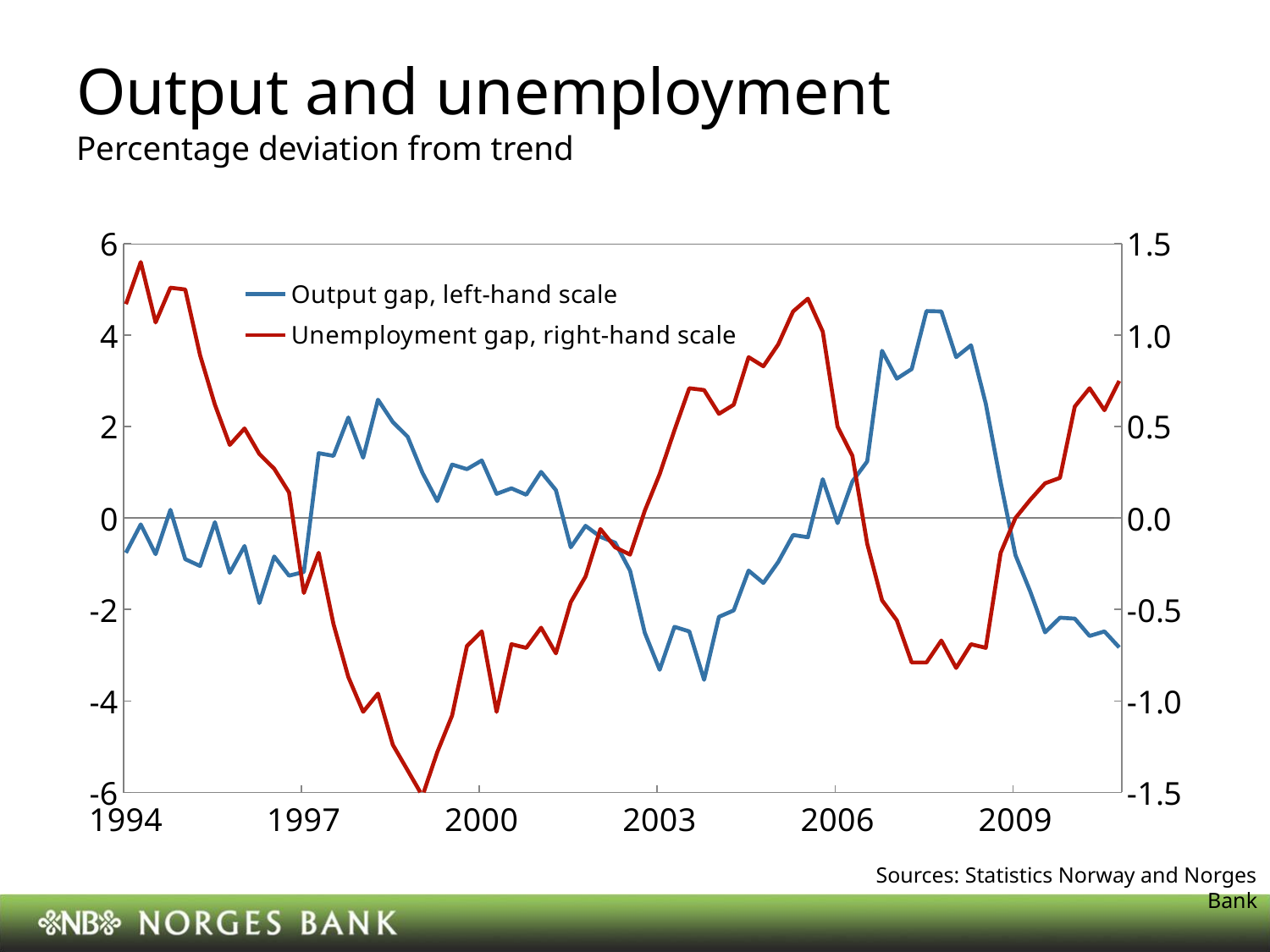
Is the peak value of the output gap around 2008 greater or less than 4 on the left-hand scale? greater Is the output gap at the start of 1994 greater or less than 0? less Which series is plotted against the right-hand scale? Unemployment gap Does the output gap rise or fall between 2006 and 2008? rise What kind of chart is shown on the slide? line chart Is the lowest value of the unemployment gap, reached around 1999, greater or less than -1.0 on the right-hand scale? less Does the unemployment gap rise or fall between 2009 and the end of the series? rise What is the title of the chart on the slide? Output and unemployment Does the unemployment gap rise or fall between 1994 and 1999? fall How many series does the legend list? 2